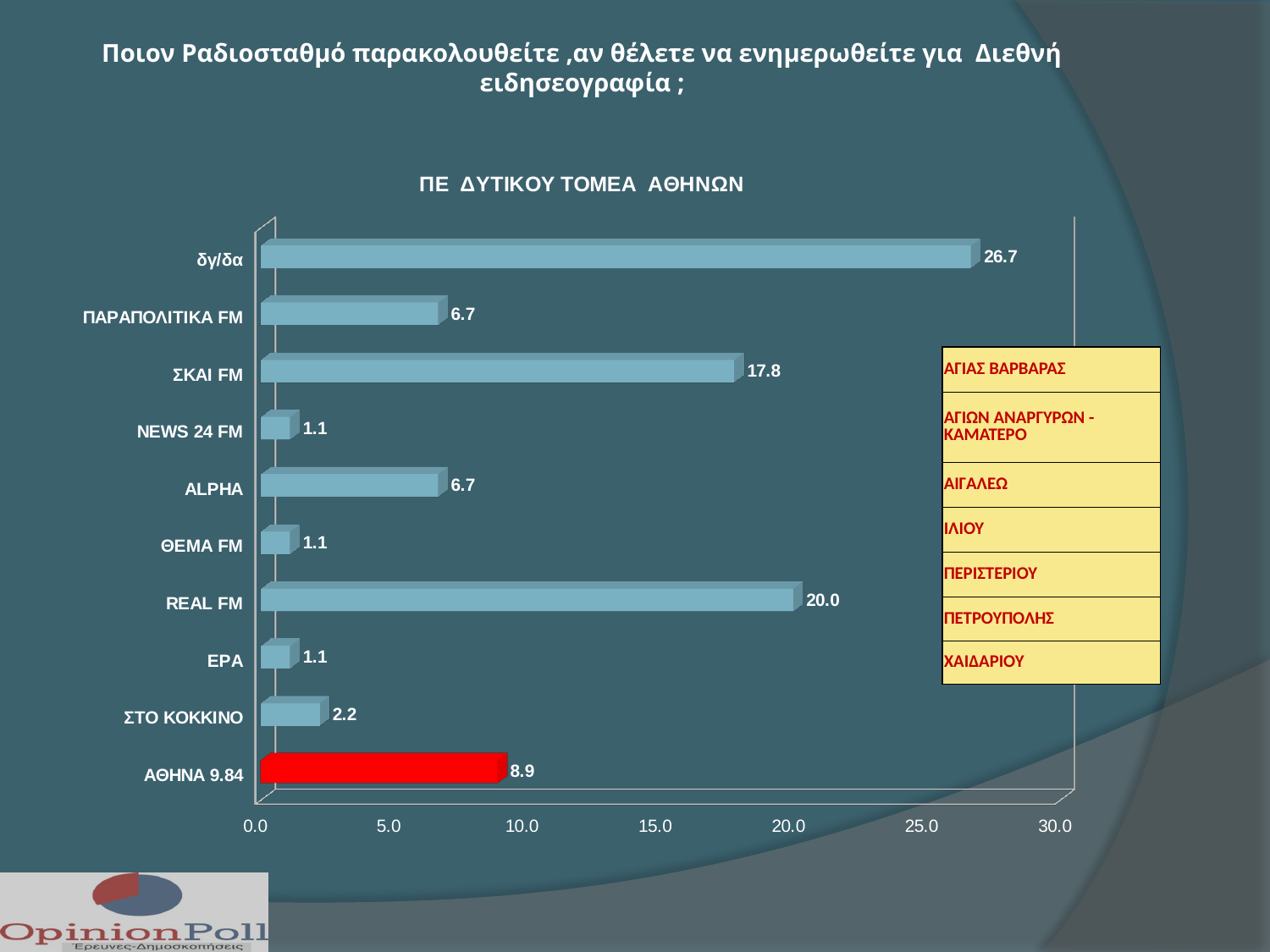
What is the value for REAL FM? 20.0 What is the value for ΑΘΗΝΑ 9.84? 8.9 How many categories are shown on the chart? 10 What is the difference between the values for δγ/δα and ΑΘΗΝΑ 9.84? 17.8 Which category's bar is coloured red? ΑΘΗΝΑ 9.84 What is the value for ΣΚΑΙ FM? 17.8 What kind of chart is shown on the slide? bar chart Which is larger, the value for ΠΑΡΑΠΟΛΙΤΙΚΑ FM or the value for ΑΘΗΝΑ 9.84? ΑΘΗΝΑ 9.84 What is the value for ΣΤΟ ΚΟΚΚΙΝΟ? 2.2 Is the value for ΣΚΑΙ FM greater or less than 15.0? greater Which category has the highest value? δγ/δα What is the difference between the values for REAL FM and ΣΚΑΙ FM? 2.2